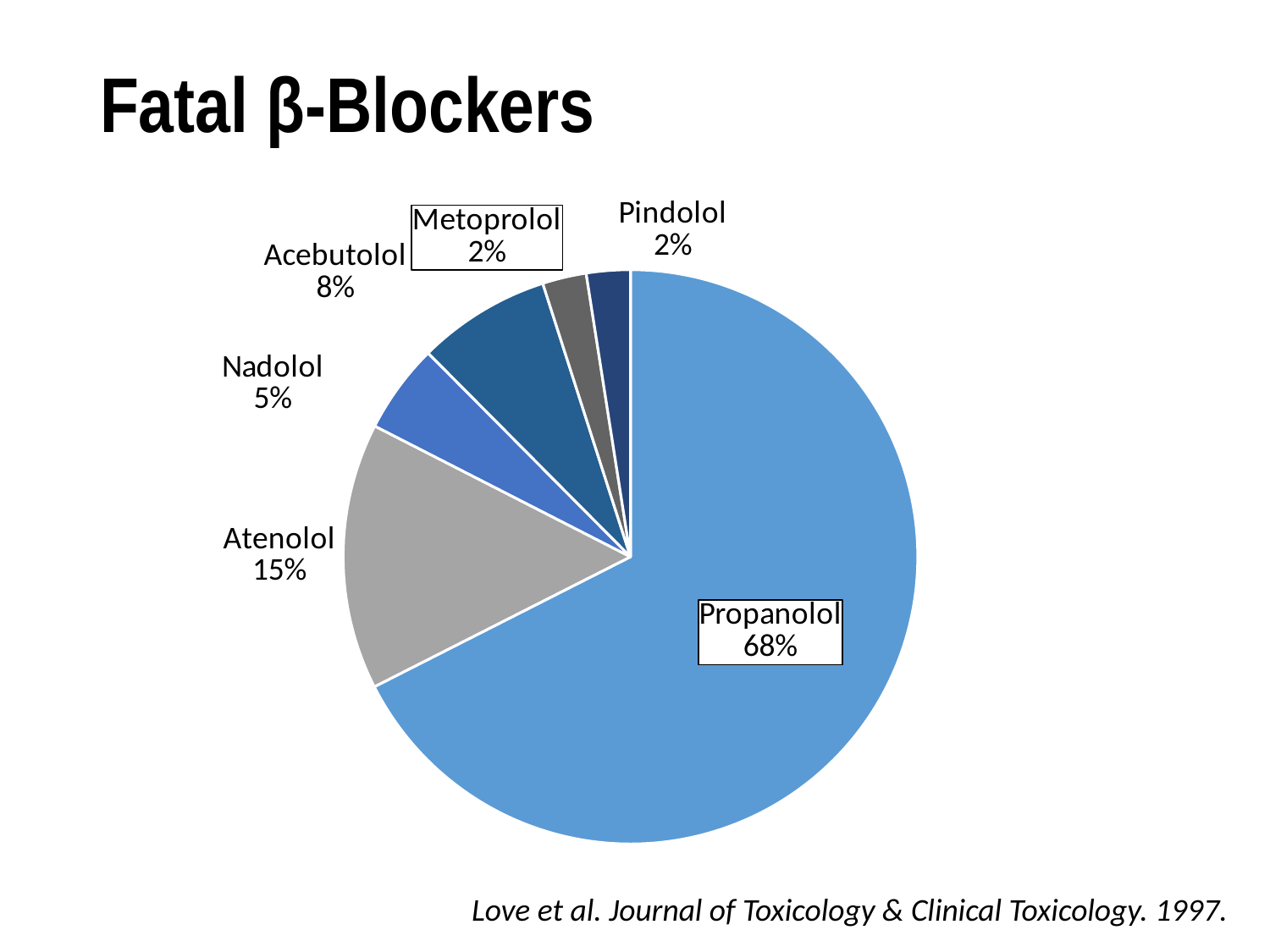
Which category has the largest slice of the pie? Propanolol What is the difference between the Acebutolol and Nadolol percentages? 3% What kind of chart is shown on the slide? pie chart What is the difference between the Propanolol and Atenolol percentages? 53% What is the value shown for Nadolol? 5% What is the title of the slide containing the chart? Fatal β-Blockers How many categories (slices) are shown in the pie chart? 6 Which two categories share the same value of 2%? Metoprolol and Pindolol What share of the pie does Propanolol account for? 68% What is the value shown for Atenolol? 15% What is the value shown for Acebutolol? 8% Which is larger, the share for Atenolol or the share for Acebutolol? Atenolol